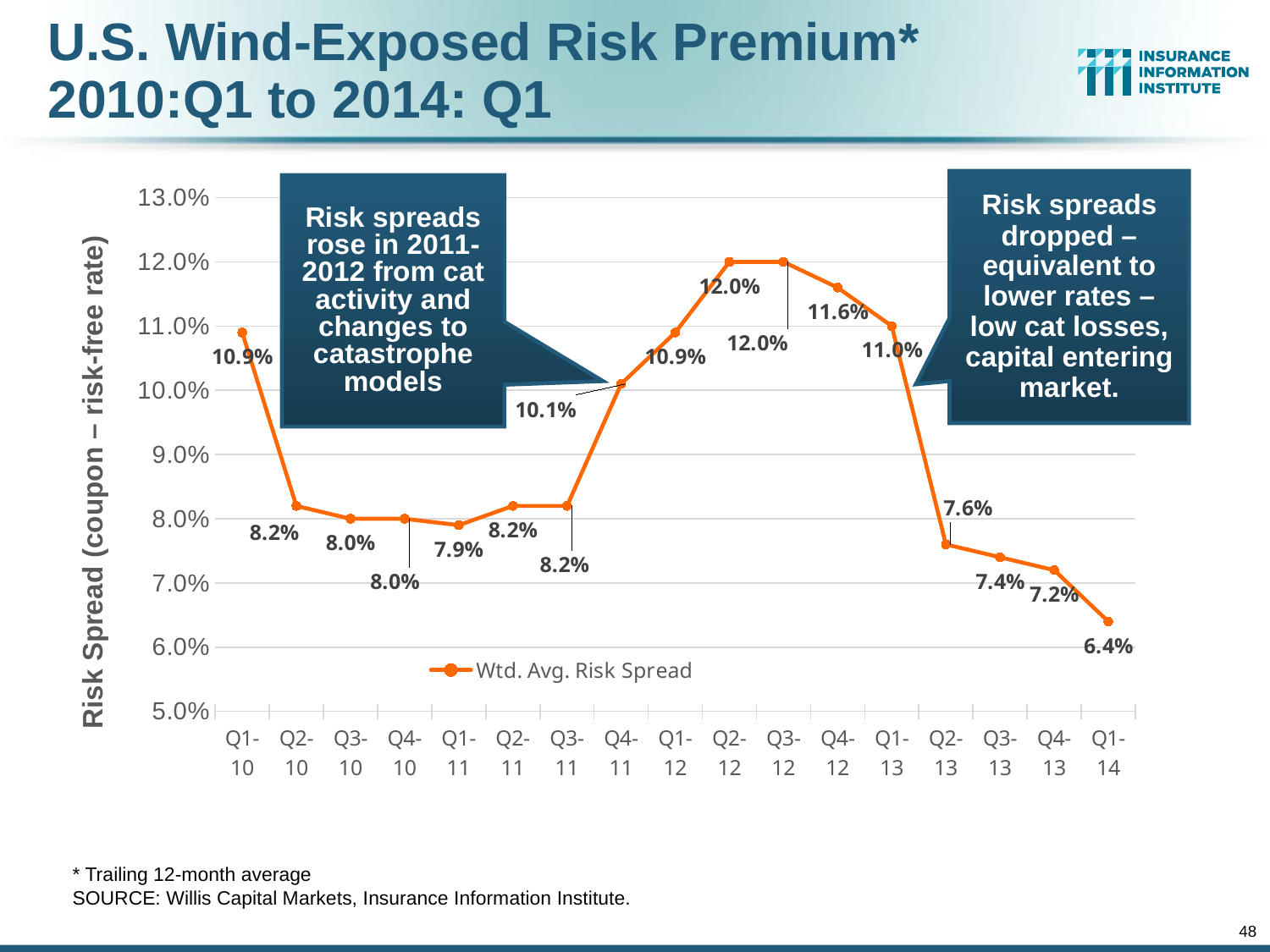
What is the highest weighted average risk spread value shown on the chart? 12.0% What is the weighted average risk spread for Q1-14? 6.4% By how many percentage points did the risk spread fall from Q1-13 to Q2-13? 3.4 percentage points What is the weighted average risk spread for Q1-11? 7.9% What type of chart is shown on the slide? Line chart Which is larger, the risk spread in Q1-10 or in Q1-14? Q1-10 How many quarters are plotted on the chart? 17 What is the weighted average risk spread for Q4-12? 11.6% Which quarter has the lowest weighted average risk spread? Q1-14 How many series does the legend list? 1 What is the weighted average risk spread for Q1-10? 10.9% Does the risk spread rise or fall from Q1-13 to Q1-14? Fall